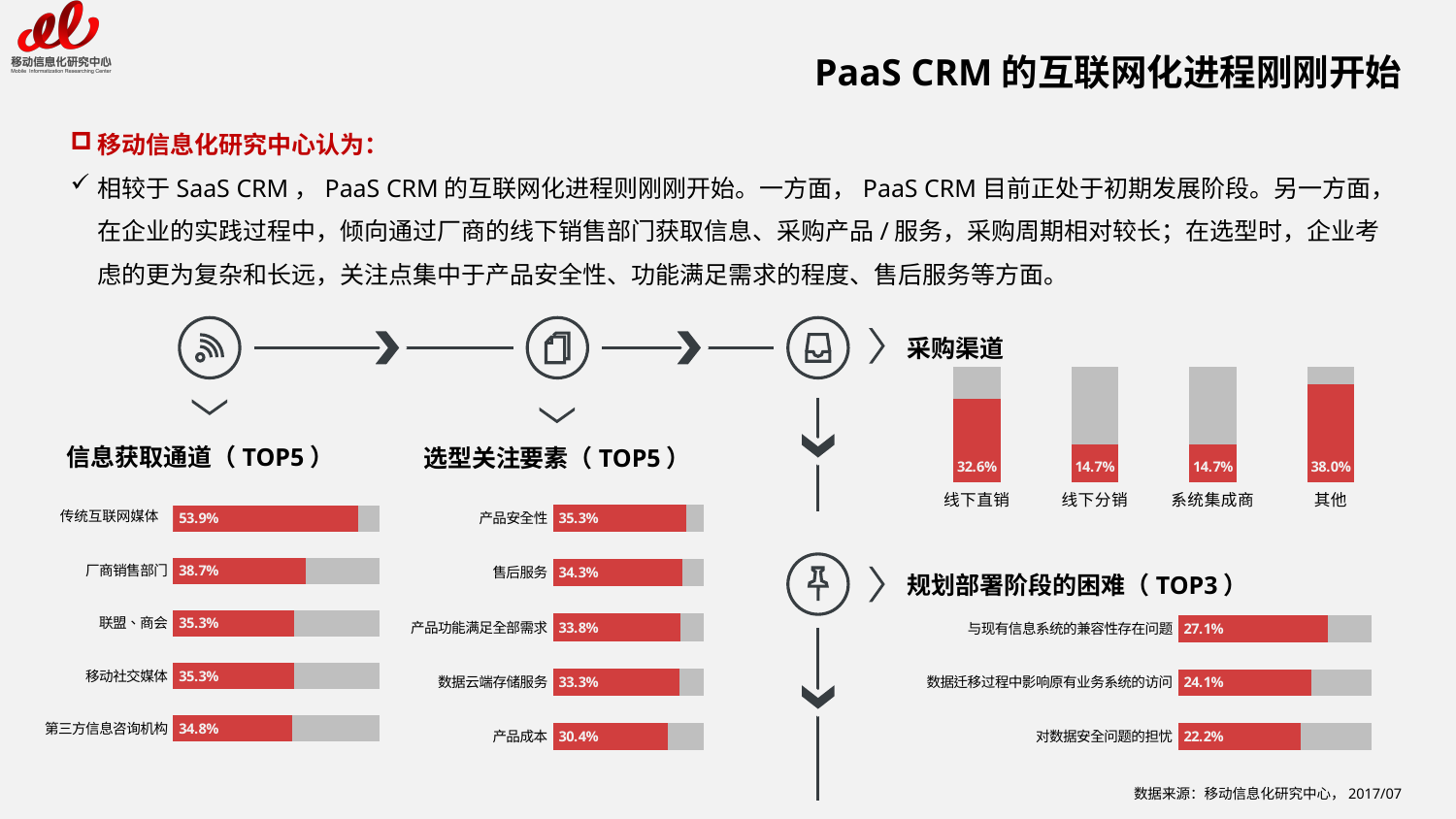
In the 选型关注要素（TOP5） chart, which category has the lowest value? 产品成本 What type of chart is the 规划部署阶段的困难（TOP3） chart? bar chart In the 采购渠道 chart, what is the value for 线下直销? 32.6% In the 选型关注要素（TOP5） chart, which is larger: 产品安全性 or 数据云端存储服务? 产品安全性 In the 信息获取通道（TOP5） chart, what is the difference between 传统互联网媒体 and 厂商销售部门? 15.2% How many categories are shown in the 信息获取通道（TOP5） chart? 5 In the 规划部署阶段的困难（TOP3） chart, what is the value for 对数据安全问题的担忧? 22.2% In the 采购渠道 chart, which category has the highest value? 其他 In the 采购渠道 chart, what is the difference between 其他 and 线下直销? 5.4% In the 信息获取通道（TOP5） chart, what is the value for 传统互联网媒体? 53.9% In the 选型关注要素（TOP5） chart, what is the value for 售后服务? 34.3% In the 信息获取通道（TOP5） chart, which category has the highest value? 传统互联网媒体